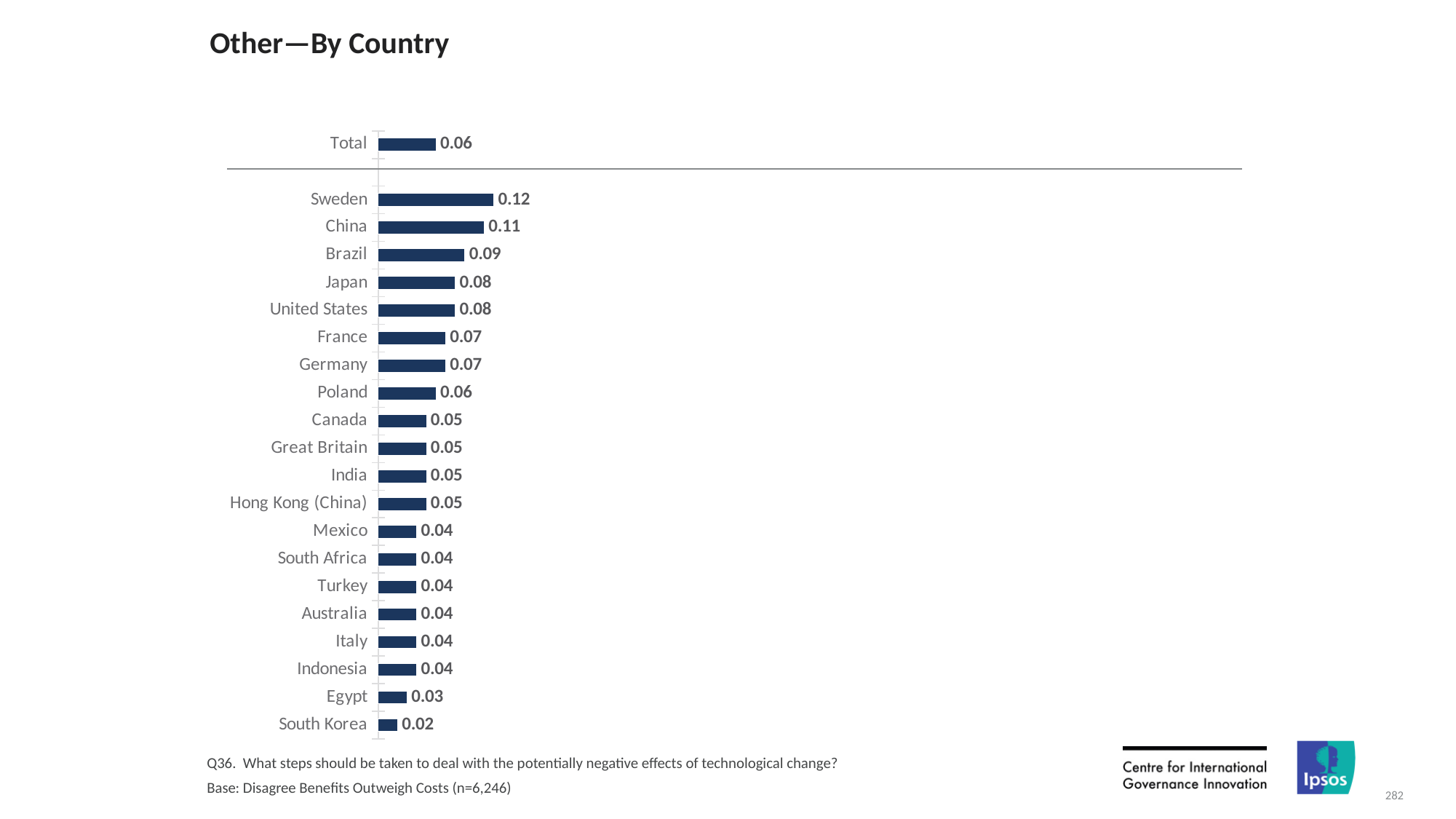
Which country has the highest value? Sweden What is the difference between the values for China and Egypt? 0.08 What is the value for Sweden? 0.12 How many countries are listed below the Total bar? 19 What is the value for Brazil? 0.09 What kind of chart is shown on the slide? Bar chart What is the difference between the values for Sweden and South Korea? 0.10 Which country has the lowest value? South Korea What is the title of the slide? Other—By Country What is the value for South Korea? 0.02 Which is larger, the value for Japan or the value for Poland? Japan What is the value for Total? 0.06